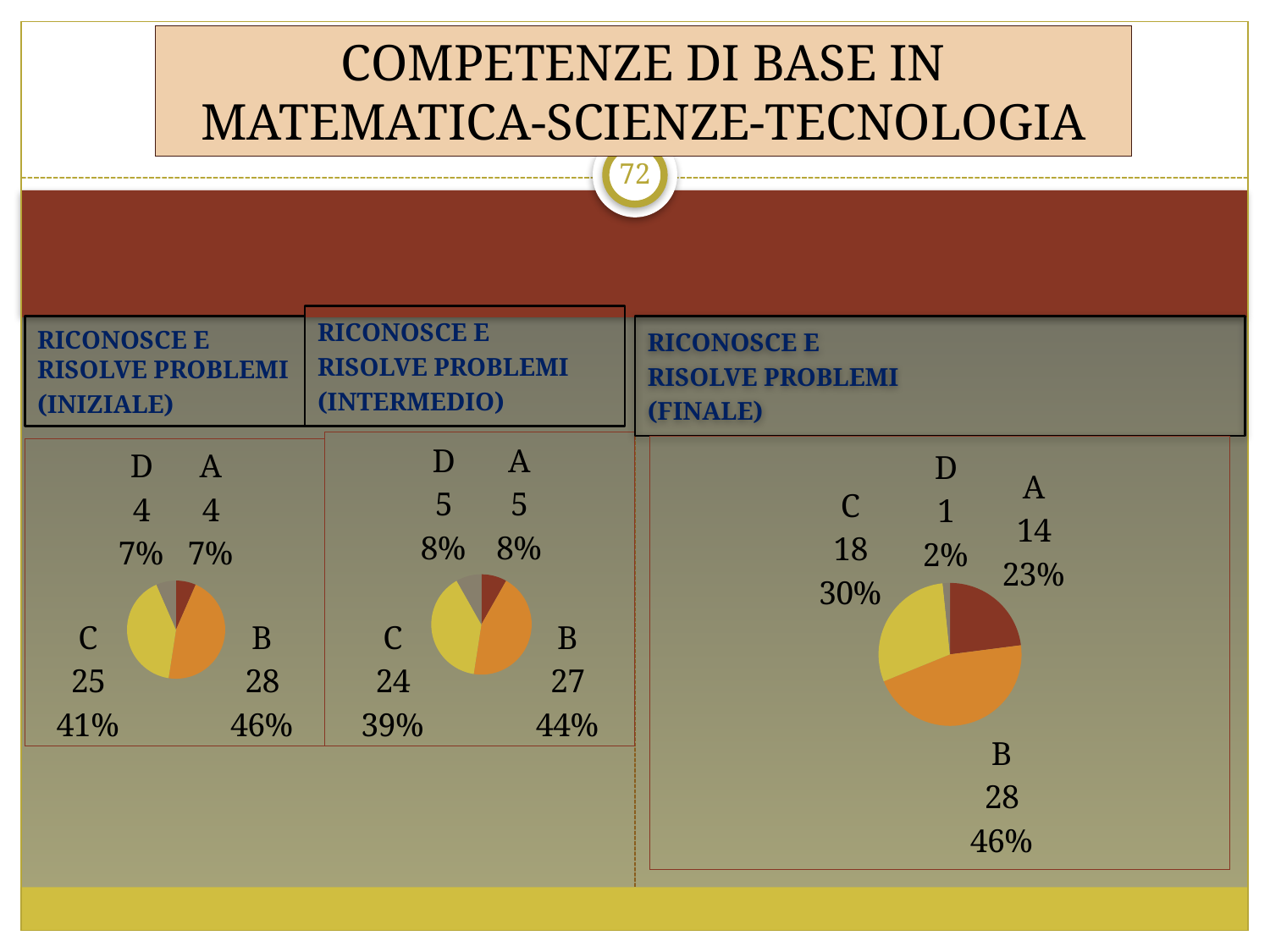
In the RICONOSCE E RISOLVE PROBLEMI (INTERMEDIO) chart, what is the value for category C? 24 In the RICONOSCE E RISOLVE PROBLEMI (INTERMEDIO) chart, which is larger, the value for B or the value for C? B How many categories does the RICONOSCE E RISOLVE PROBLEMI (INIZIALE) chart show? 4 In the RICONOSCE E RISOLVE PROBLEMI (FINALE) chart, what is the value for category A? 14 In the RICONOSCE E RISOLVE PROBLEMI (FINALE) chart, what is the difference between the values for C and A? 4 What kind of chart is used for RICONOSCE E RISOLVE PROBLEMI (FINALE)? Pie chart In the RICONOSCE E RISOLVE PROBLEMI (INIZIALE) chart, what is the value for category B? 28 In the RICONOSCE E RISOLVE PROBLEMI (INTERMEDIO) chart, which category has the largest slice? B In the RICONOSCE E RISOLVE PROBLEMI (INIZIALE) chart, what is the difference between the values for B and C? 3 In the RICONOSCE E RISOLVE PROBLEMI (FINALE) chart, what percentage share does category B have? 46% In the RICONOSCE E RISOLVE PROBLEMI (FINALE) chart, which category has the smallest slice? D In the RICONOSCE E RISOLVE PROBLEMI (INIZIALE) chart, what percentage share does category C have? 41%